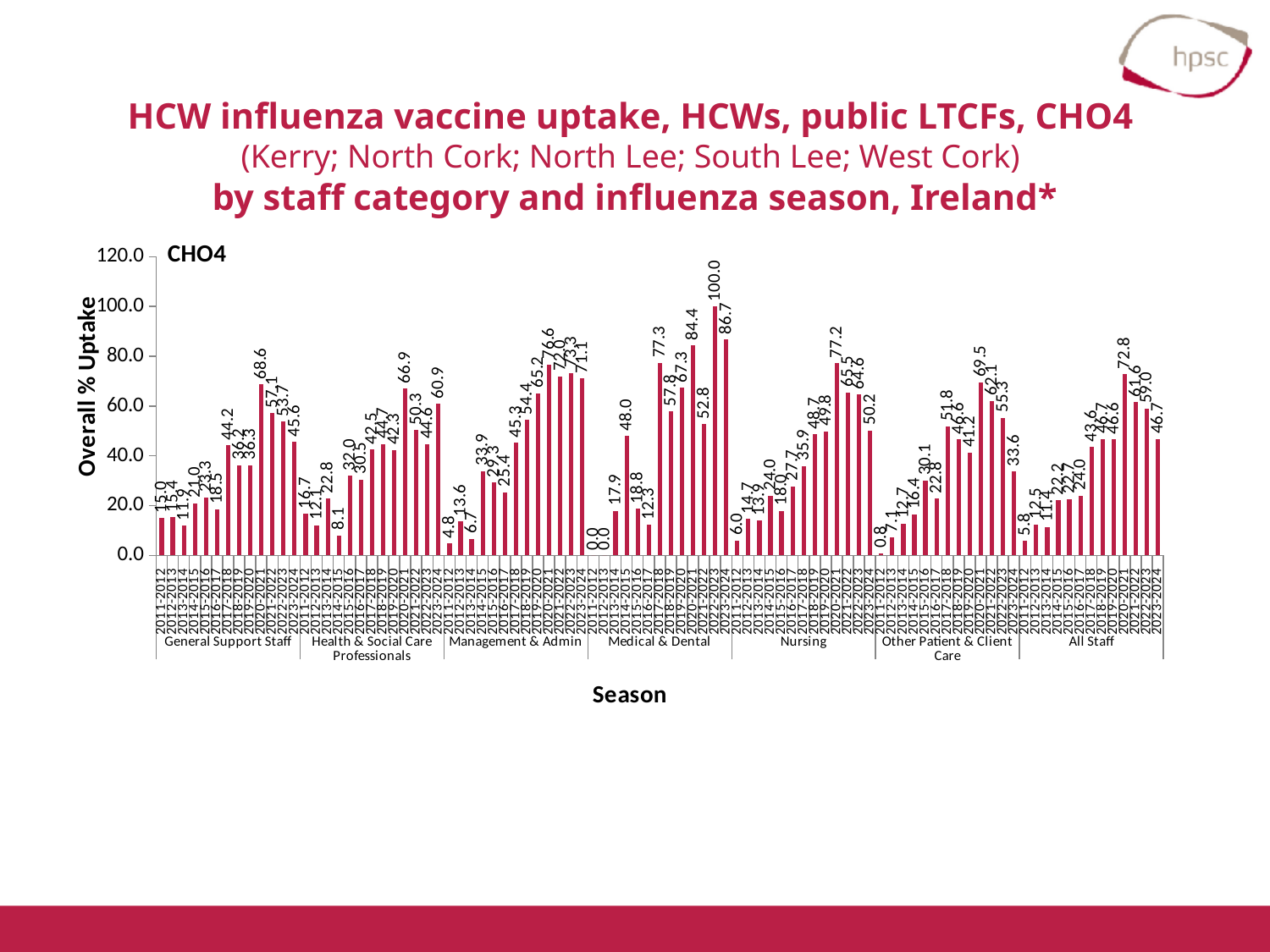
What is the title of the vertical axis? Overall % Uptake What is the overall % uptake for Other Patient & Client Care in the 2020-2021 season? 69.5 What is the overall % uptake for Nursing in the 2020-2021 season? 77.2 Which staff category and season has the highest overall % uptake? Medical & Dental, 2022-2023 In the 2020-2021 season, which had the higher overall % uptake: Nursing or General Support Staff? Nursing What is the overall % uptake for Medical & Dental in the 2022-2023 season? 100.0 Is the overall % uptake for Medical & Dental in 2023-2024 greater or less than 80.0? greater How many staff categories are shown along the x axis? 7 What is the overall % uptake for All Staff in the 2021-2022 season? 61.6 What kind of chart is shown on the slide? Bar chart What is the overall % uptake for General Support Staff in the 2020-2021 season? 68.6 What is the difference in overall % uptake for Medical & Dental between the 2022-2023 and 2023-2024 seasons? 13.3